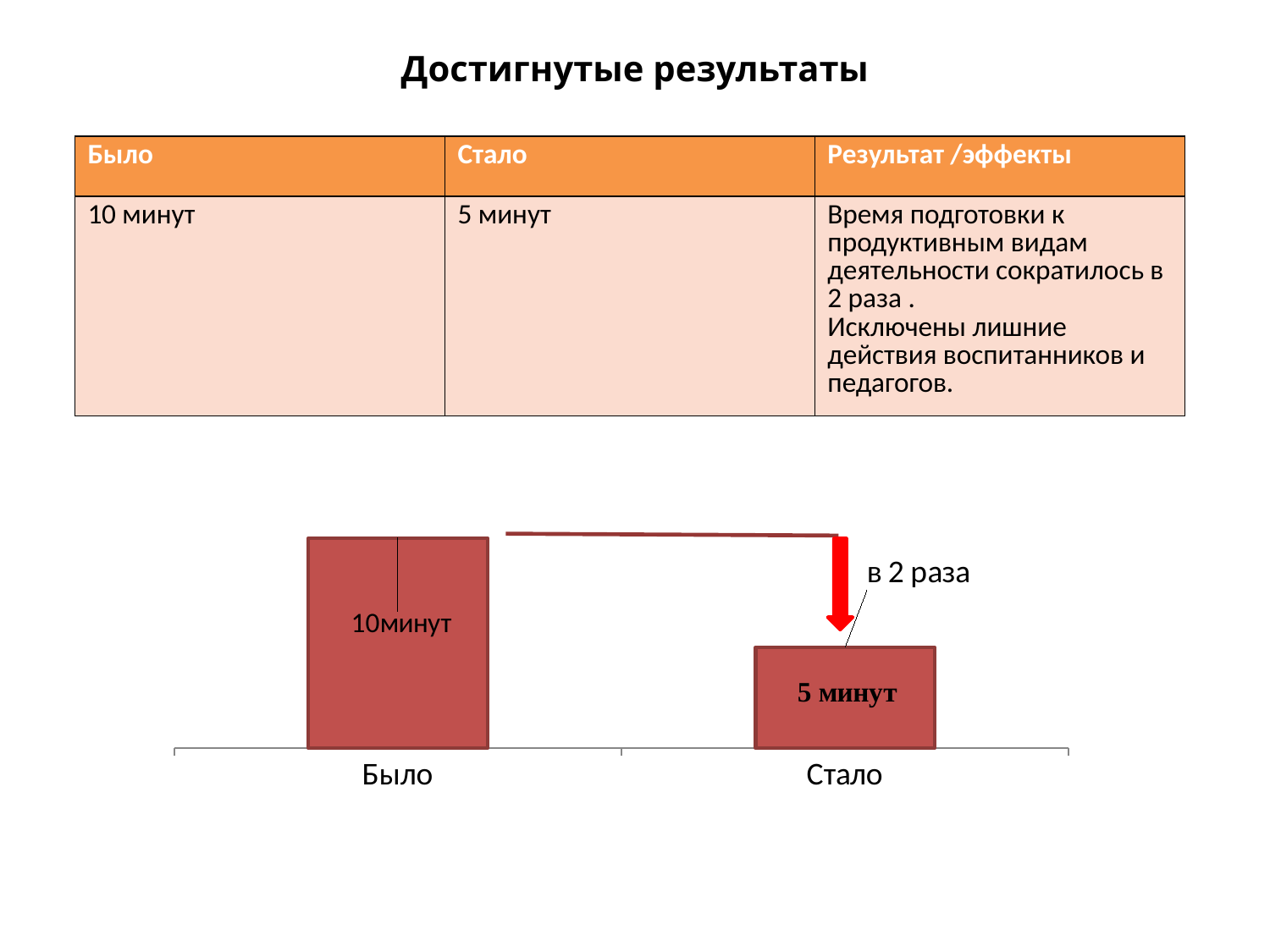
How many bars (categories) does the chart show? 2 What type of chart is shown on the slide? bar chart Which category has the highest value in the chart? Было What are the two category labels on the x axis of the chart? Было, Стало Which category has the lowest value in the chart? Стало What text is written next to the red arrow above the "Стало" bar? в 2 раза Do the values rise or fall from "Было" to "Стало"? fall Which category has the taller bar, "Было" or "Стало"? Было What value is labelled on the bar for "Стало"? 5 минут What value is labelled on the bar for "Было"? 10минут By how many minutes does the "Было" bar exceed the "Стало" bar? 5 минут